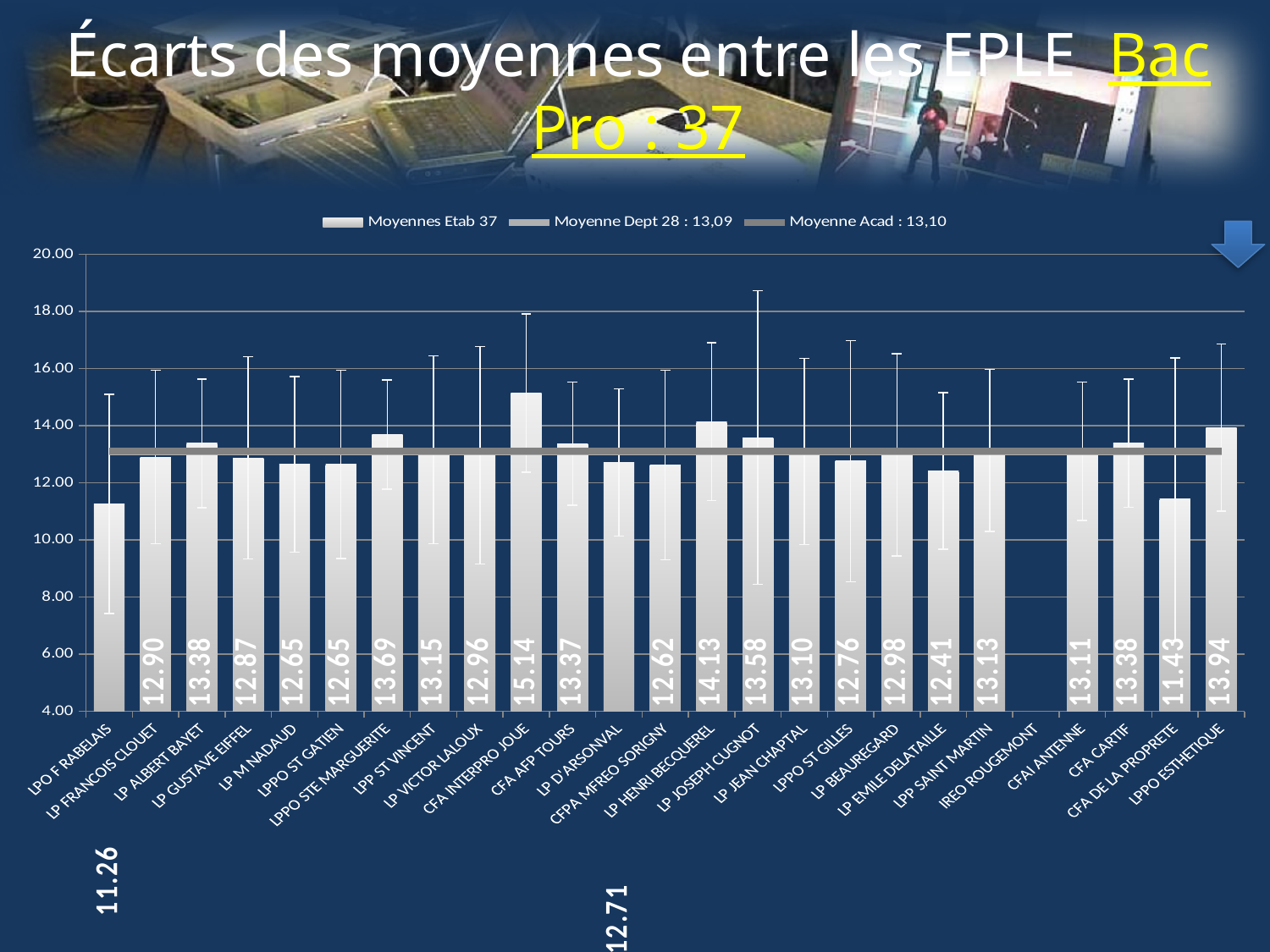
What is the value for LP EMILE DELATAILLE? 12.41 How many series does the legend list? 3 What is the value for LP HENRI BECQUEREL? 14.13 Which is larger, the value for LPPO STE MARGUERITE or LPP ST VINCENT? LPPO STE MARGUERITE How many establishments are listed on the x axis? 25 What is the difference between the values for LPPO ESTHETIQUE and CFA CARTIF? 0.56 Is the value for CFA INTERPRO JOUE greater or less than 14.00? greater What is the difference between the values for CFA INTERPRO JOUE and LP HENRI BECQUEREL? 1.01 What value does the legend give for Moyenne Dept 28? 13,09 What is the value for CFA INTERPRO JOUE? 15.14 Which establishment has the highest value? CFA INTERPRO JOUE What is the value for LPPO ESTHETIQUE? 13.94